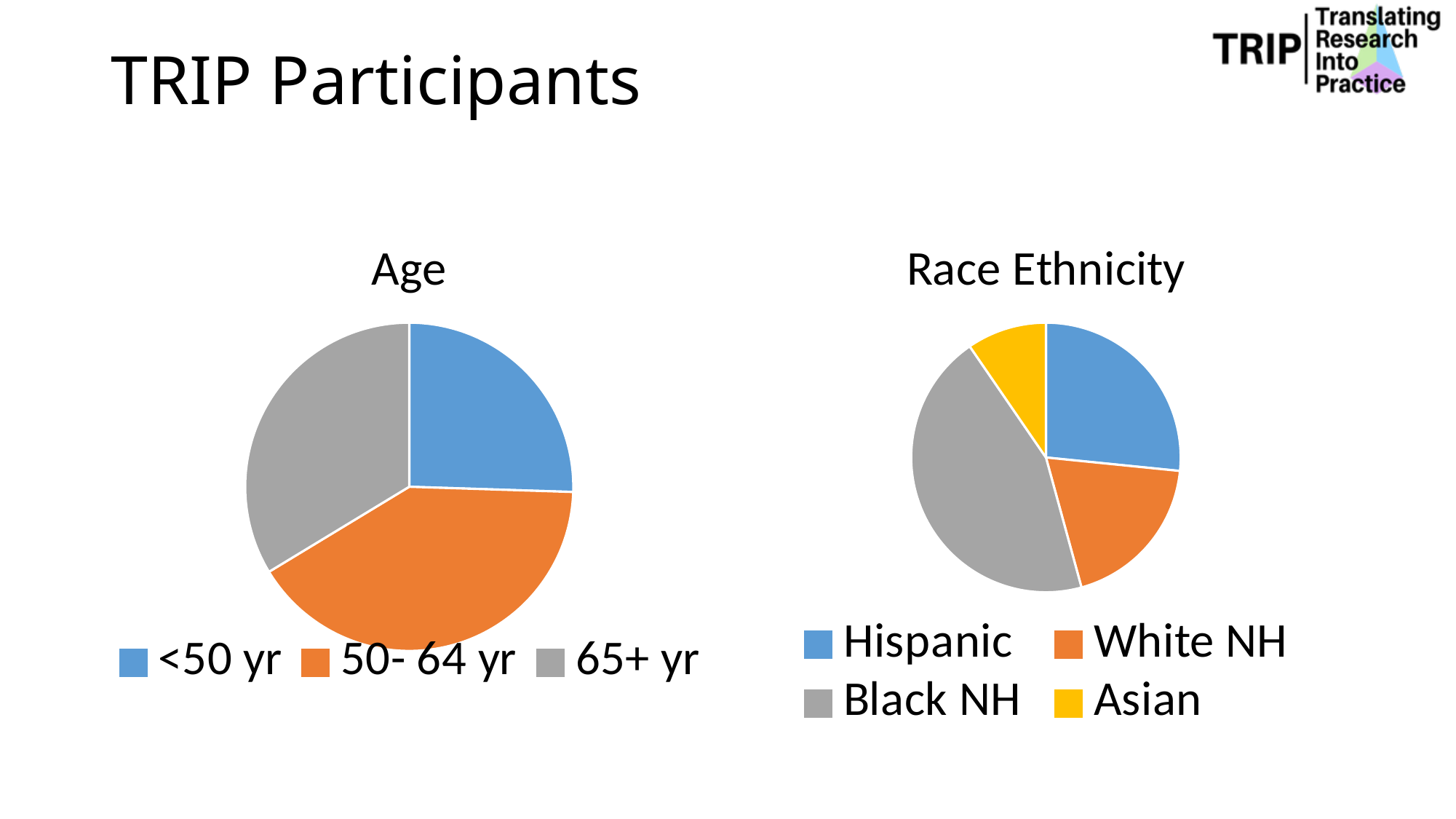
In the Age chart, which slice is larger, 50- 64 yr or <50 yr? 50- 64 yr In the Race Ethnicity chart, which colour represents Asian? yellow In the Race Ethnicity chart, which group has the largest slice? Black NH In the Race Ethnicity chart, which slice is larger, Black NH or Hispanic? Black NH In the Race Ethnicity chart, how many slices does the pie have? 4 In the Age chart, how many slices does the pie have? 3 In the Race Ethnicity chart, which group has the smallest slice? Asian What kind of chart is the Race Ethnicity chart? pie chart In the Age chart, which age group has the smallest slice? <50 yr What kind of chart is the Age chart? pie chart In the Age chart, which age group has the largest slice? 50- 64 yr What is the title of the chart on the left of the slide? Age